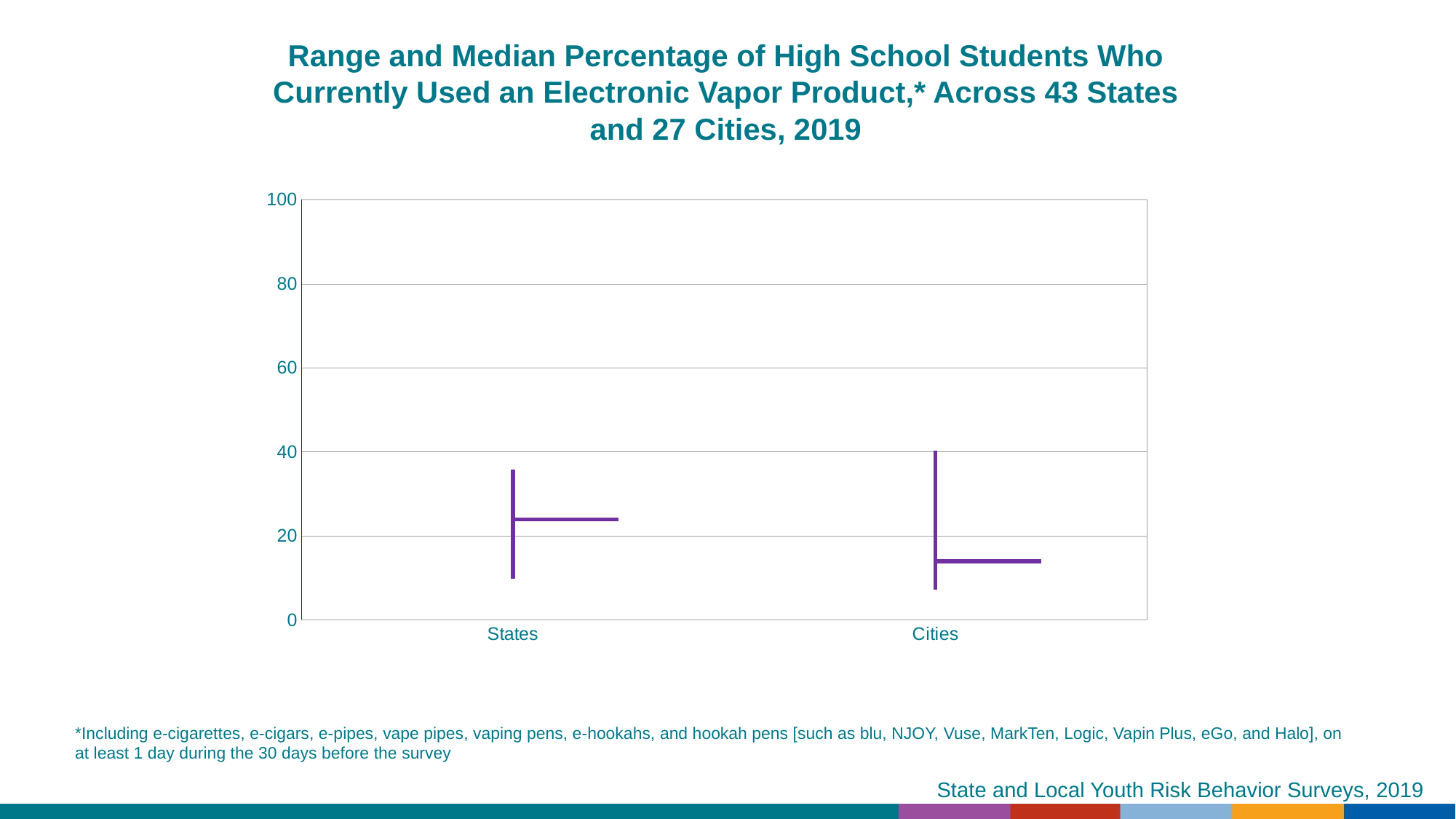
Is the bottom of the range for States greater or less than 20? less Is the median value for States greater or less than 20? greater Which category has the lower median percentage? Cities Which category has the higher median percentage, States or Cities? States Is the top of the range for States greater or less than 40? less What is the highest value shown on the y axis of the chart? 100 What year does the chart title say the data are from? 2019 How many categories are shown on the x axis of the chart? 2